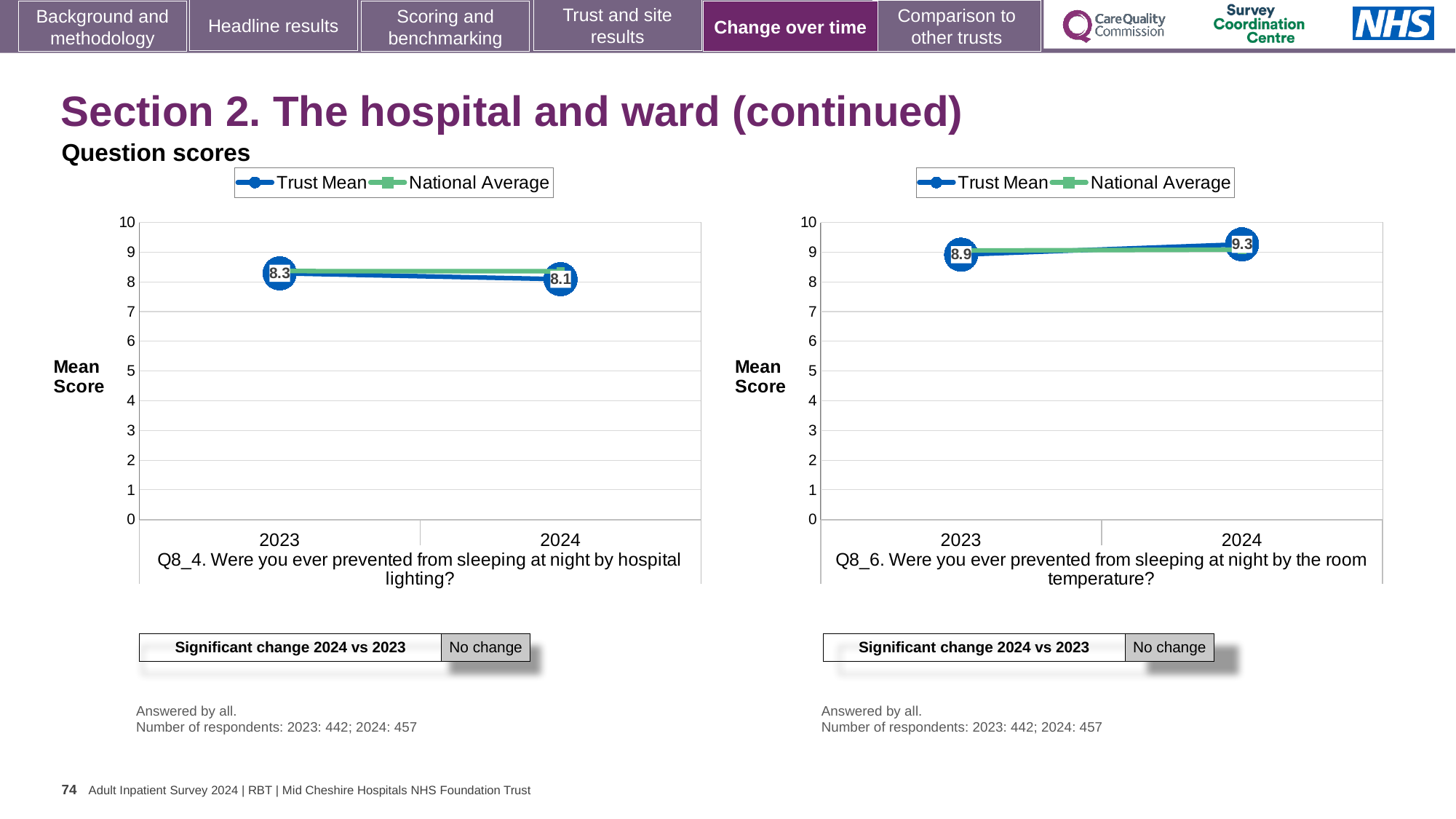
In the Q8_4 chart (hospital lighting), what is the Trust Mean for 2024? 8.1 In the Q8_4 chart (hospital lighting), does the Trust Mean rise or fall from 2023 to 2024? fall In the Q8_4 chart (hospital lighting), what is the Trust Mean for 2023? 8.3 In the Q8_6 chart (room temperature), what is the Trust Mean for 2023? 8.9 How many series does the legend of the Q8_6 chart (room temperature) list? 2 In the Q8_6 chart (room temperature), does the Trust Mean rise or fall from 2023 to 2024? rise In the Q8_6 chart (room temperature), what is the Trust Mean for 2024? 9.3 In the Q8_6 chart (room temperature), which year has the higher Trust Mean? 2024 What type of chart is the Q8_4 chart (hospital lighting)? line chart In the Q8_4 chart (hospital lighting), is the Trust Mean for 2024 greater or less than 9? less In the Q8_4 chart (hospital lighting), what is the difference between the Trust Mean in 2023 and 2024? 0.2 In the Q8_6 chart (room temperature), what is the difference between the Trust Mean in 2024 and 2023? 0.4